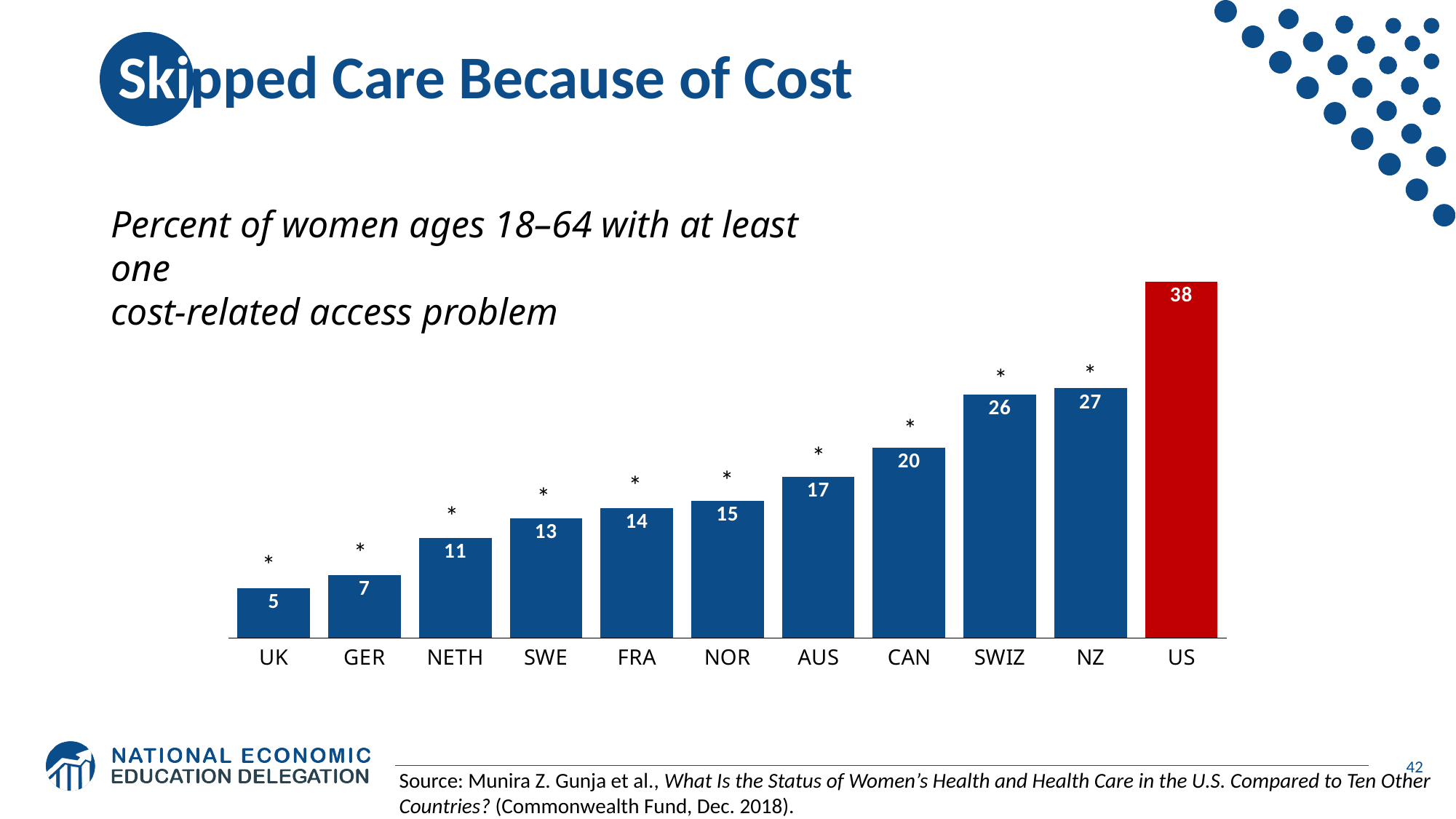
What is the difference between the values for the US and NZ? 11 Which has a larger value, AUS or FRA? AUS Which bar is coloured red rather than blue? US What is the value for Canada (CAN)? 20 Which country has the highest value? US Do the values rise or fall from left to right along the x axis? rise What is the value for Germany (GER)? 7 What is the value for the US? 38 What kind of chart is shown on the slide? bar chart What is the difference between the values for SWE and UK? 8 Which country has the lowest value? UK How many countries are shown in the chart? 11